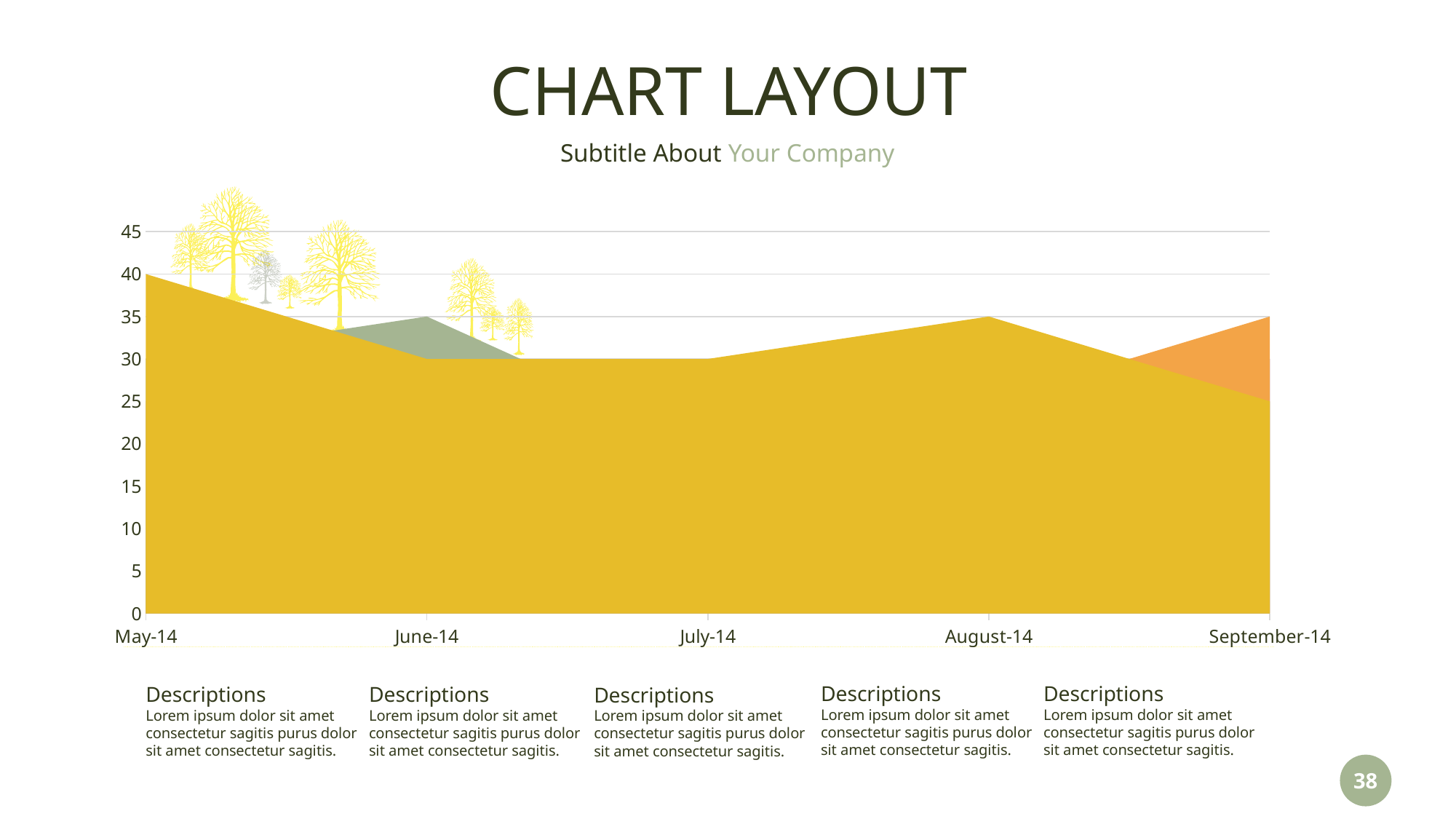
What kind of chart is shown on the slide? area chart What is the title of the slide containing the chart? CHART LAYOUT What is the value of the yellow series at September-14? 25 Is the value of the yellow series at July-14 greater or less than 35? less How many months are labelled along the x axis of the chart? 5 Which is larger for the yellow series: the value at May-14 or at August-14? May-14 What is the value of the yellow series at May-14? 40 What is the difference between the yellow series value at May-14 and at September-14? 15 At which month does the yellow series reach its lowest value? September-14 What is the value of the yellow series at August-14? 35 Does the yellow series rise or fall from August-14 to September-14? fall At which month does the yellow series reach its highest value? May-14